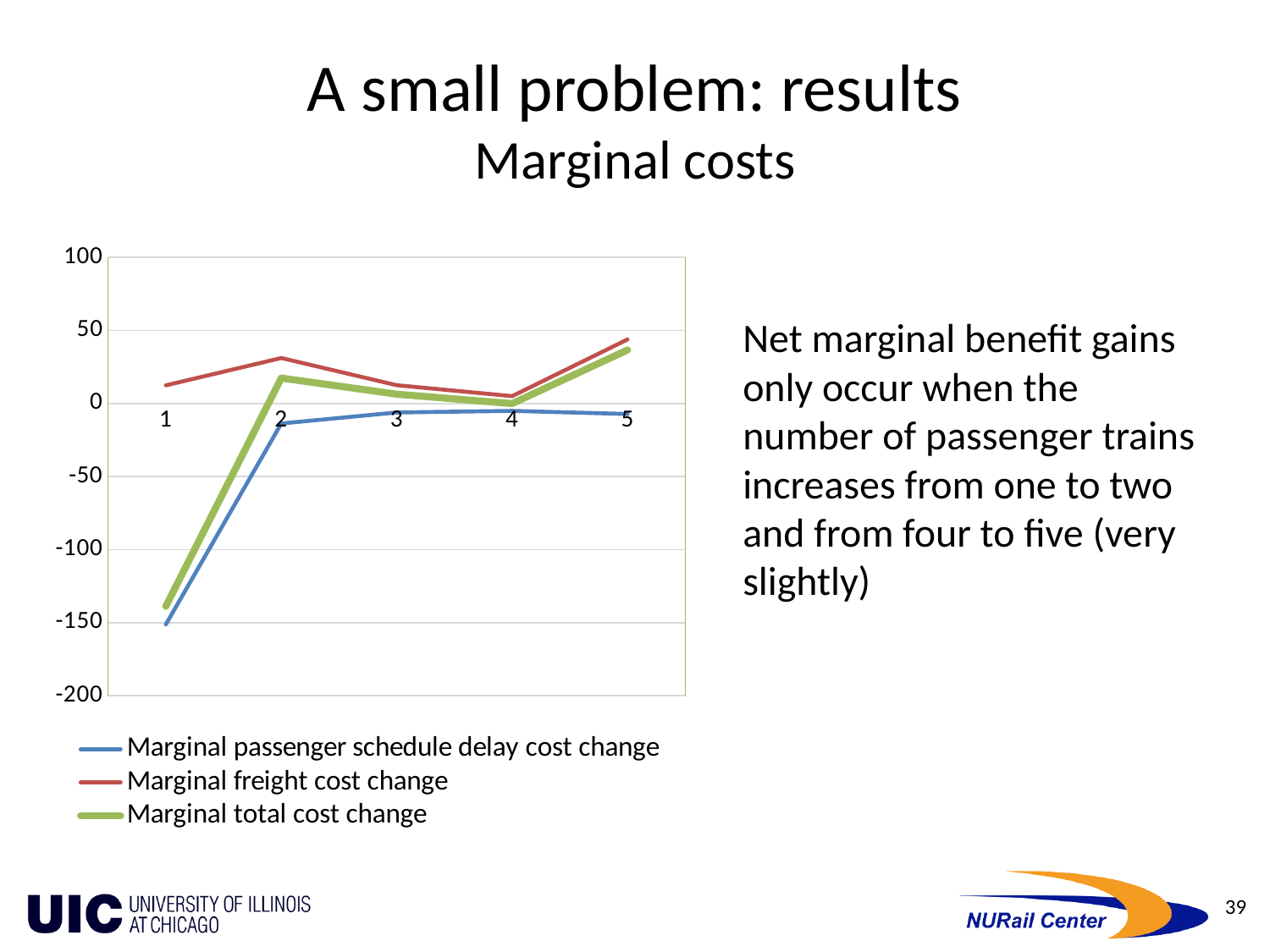
Is the value of Marginal total cost change at x = 1 greater or less than -100? less How many points are plotted along the x axis for each series? 5 At x = 1, which is larger: Marginal freight cost change or Marginal passenger schedule delay cost change? Marginal freight cost change At which x value does Marginal freight cost change reach its highest point? 5 Does Marginal passenger schedule delay cost change rise or fall from x = 1 to x = 2? rise How many series does the legend list? 3 Which colour is used for the Marginal total cost change line? green Is the value of Marginal passenger schedule delay cost change at x = 1 greater or less than -100? less What kind of chart is shown on the slide? line chart At which x value does Marginal passenger schedule delay cost change reach its lowest point? 1 Is the value of Marginal freight cost change at x = 5 greater or less than 0? greater